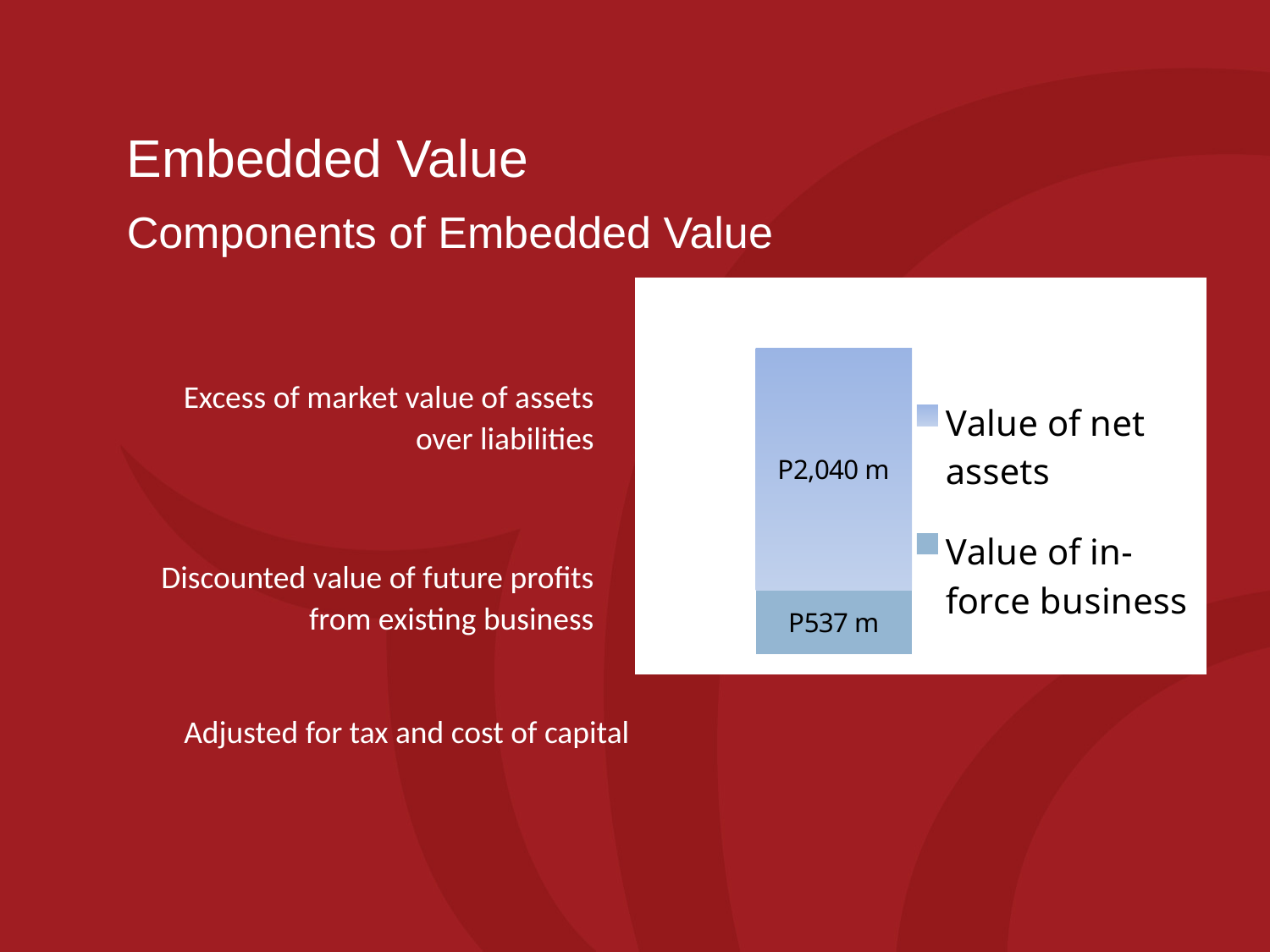
What is the total of the stacked bar (P2,040 m plus P537 m)? P2,577 m What is the value of in-force business shown in the chart? P537 m Which component has the smallest value in the chart? Value of in-force business How many series does the chart legend list? 2 Which segment of the bar is larger, P2,040 m or P537 m? P2,040 m What value is printed on the top segment of the bar? P2,040 m What is the difference between the two segments of the bar, P2,040 m and P537 m? P1,503 m Which component has the largest value in the chart? Value of net assets What value is printed on the bottom segment of the bar? P537 m What kind of chart is shown on the slide? Stacked bar chart What is the value of net assets shown in the chart? P2,040 m What are the two entries in the chart legend? Value of net assets; Value of in-force business